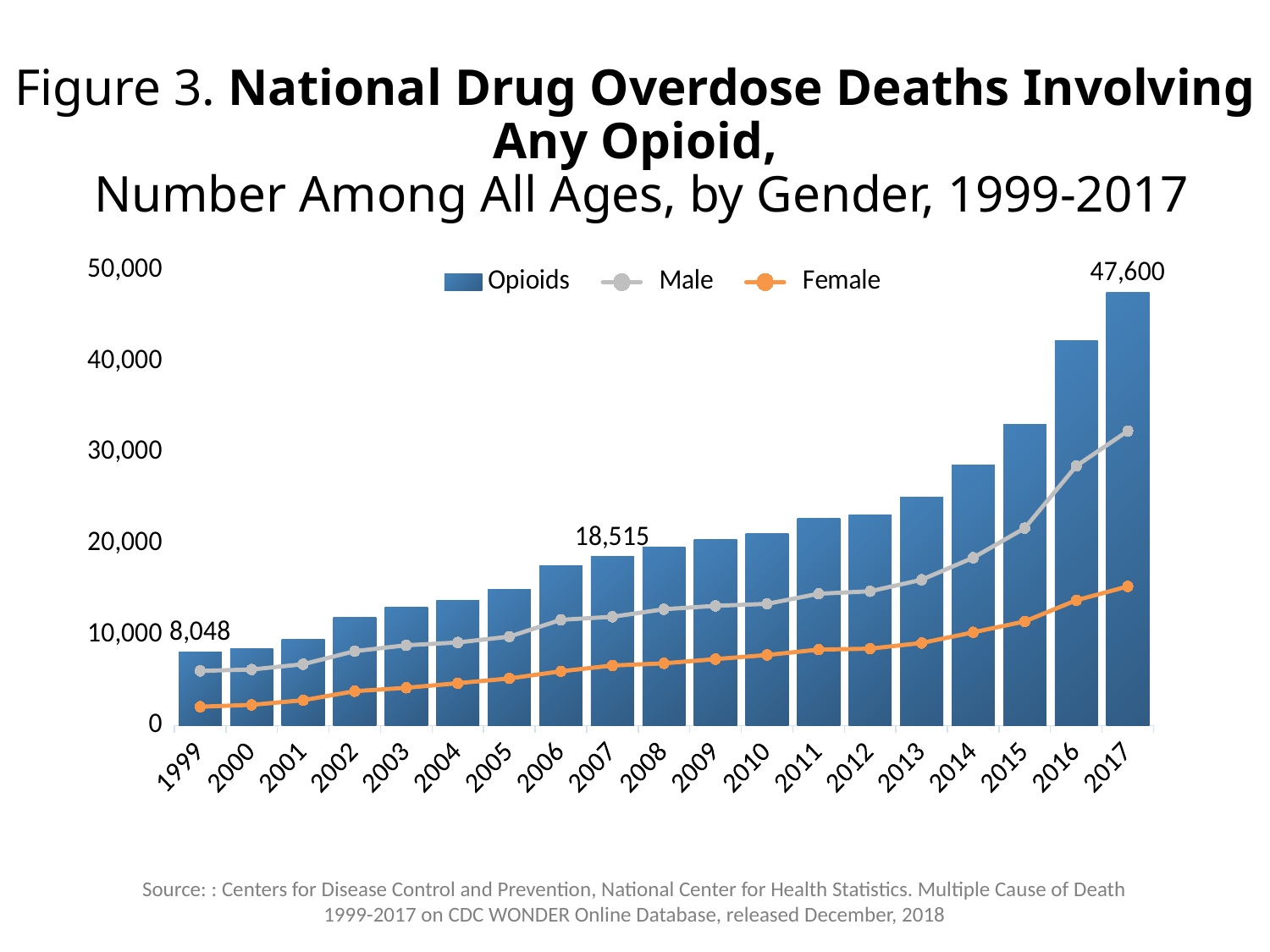
How many series does the legend list? 3 Is the Opioids value for 2016 greater or less than 40,000? greater What is the difference between the opioid deaths in 2017 and in 1999? 39,552 In 2017, which line is higher, Male or Female? Male Is the Female value for 2017 greater or less than 20,000? less What is the difference between the opioid deaths in 2007 and in 1999? 10,467 What is the number of opioid overdose deaths shown for 2017? 47,600 Which year has the lowest Opioids bar? 1999 Which year has the highest Opioids bar? 2017 How many years are shown on the x axis? 19 What is the number of opioid overdose deaths shown for 1999? 8,048 What is the number of opioid overdose deaths shown for 2007? 18,515